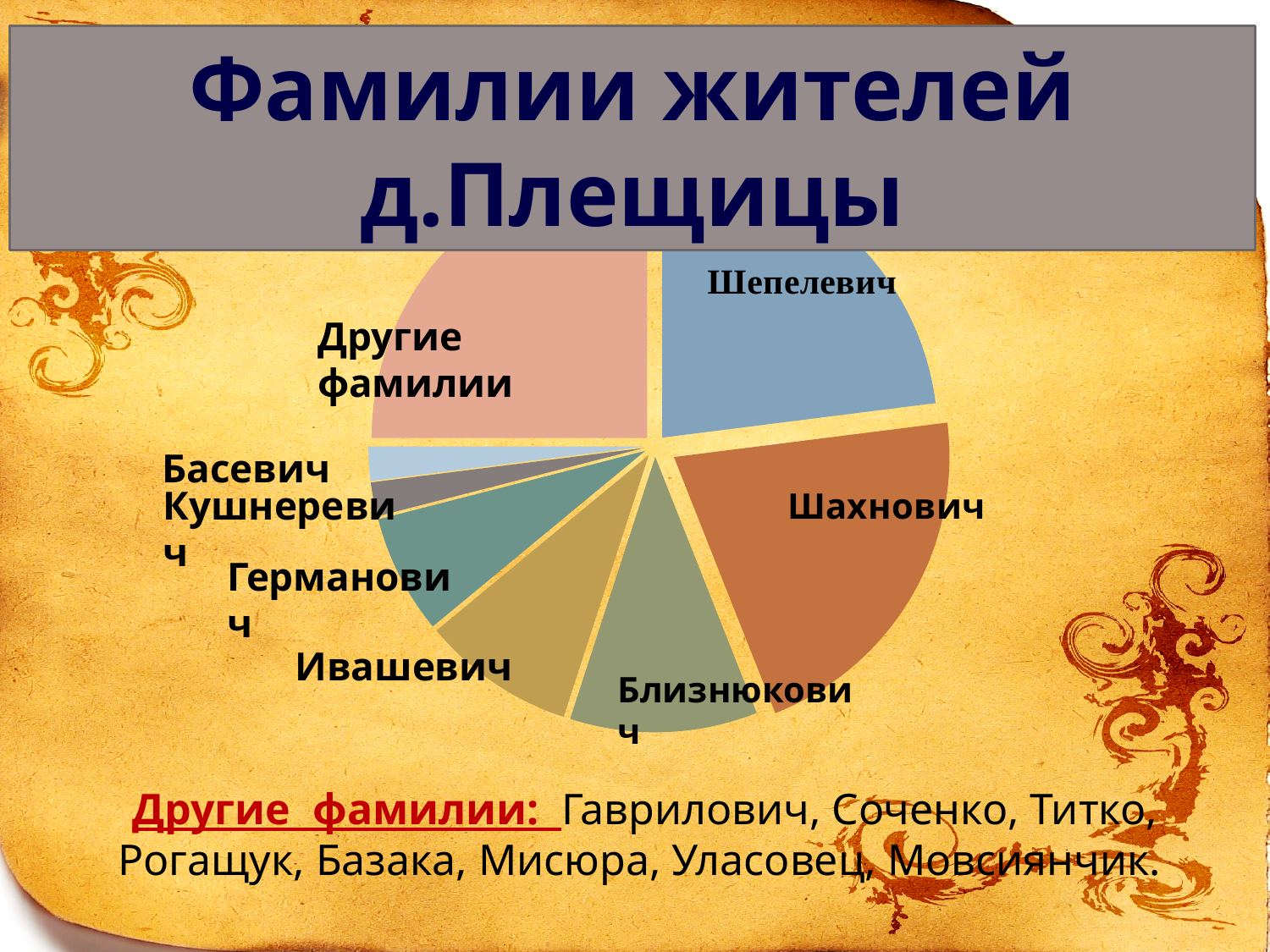
Which surname slice is labelled at the top right of the pie? Шепелевич What is the title of the slide containing the chart? Фамилии жителей д.Плещицы What kind of chart is shown on the slide? pie chart Which slice is larger, Другие фамилии or Германович? Другие фамилии Which slice is larger, Шепелевич or Ивашевич? Шепелевич Which slice is larger, Шахнович or Близнюкович? Шахнович